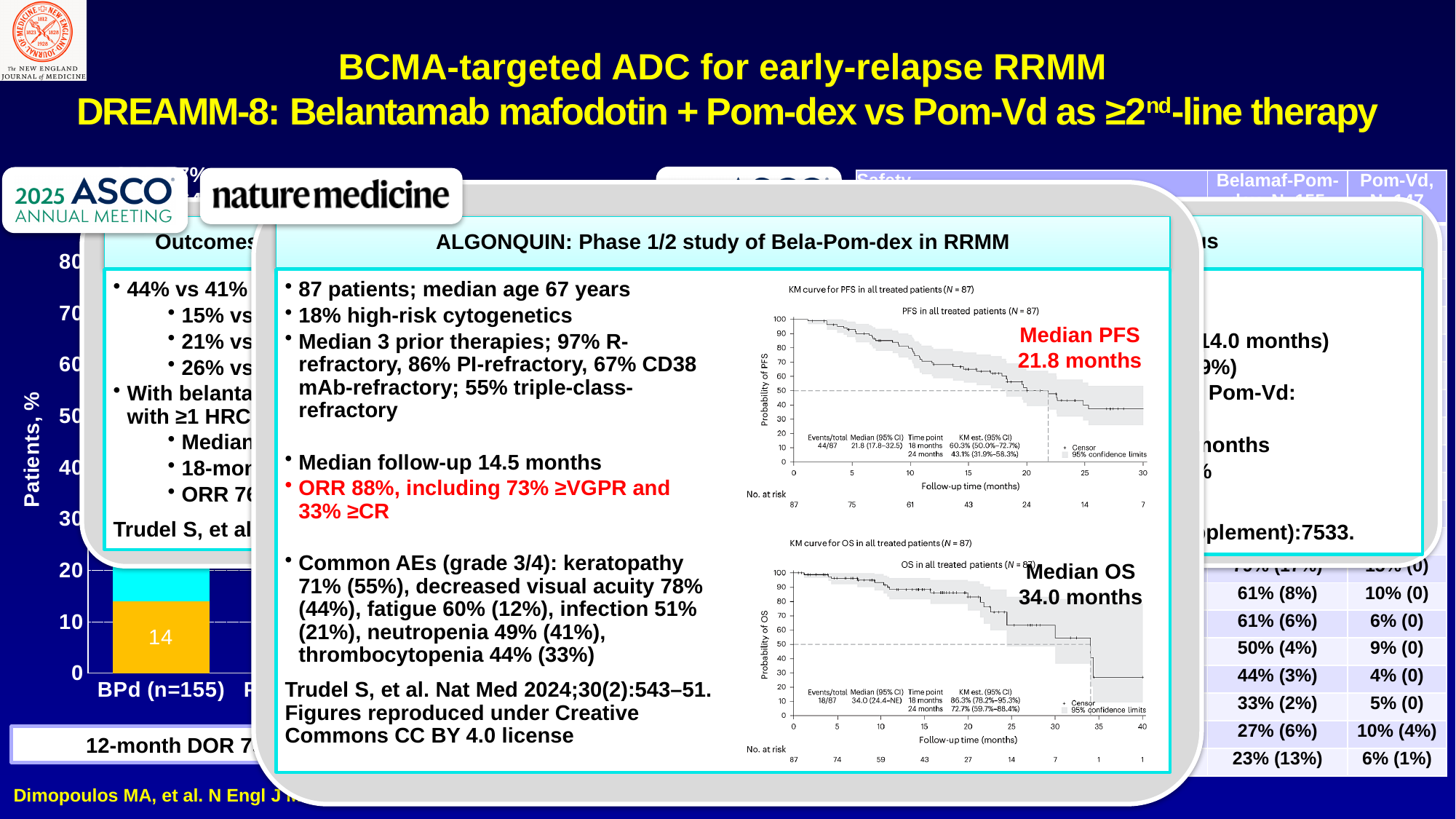
Which is larger, the median OS or the median PFS shown in the ALGONQUIN KM curves? Median OS In the KM curve for PFS, how many patients are at risk at 15 months of follow-up? 43 In the KM curve for PFS, does the probability of PFS rise or fall as follow-up time increases? fall In the KM curve for PFS in all treated patients, what is the median PFS? 21.8 months In the KM curve for OS in all treated patients, what is the median OS? 34.0 months What kind of chart is the partially visible chart on the left with the y-axis labelled 'Patients, %'? bar chart What is the difference in months between the median OS (34.0 months) and the median PFS (21.8 months) in the ALGONQUIN KM curves? 12.2 months In the bar chart on the left, what value is printed on the orange segment of the BPd (n=155) bar? 14 In the KM curve for OS, how many patients are at risk at 10 months of follow-up? 59 In the KM curve for OS, what is the 18-month KM estimate of OS? 86.3% In the KM curve for PFS, is the probability of PFS at 30 months greater or less than 50? less In the KM curve for PFS, what is the 24-month KM estimate of PFS? 43.1%